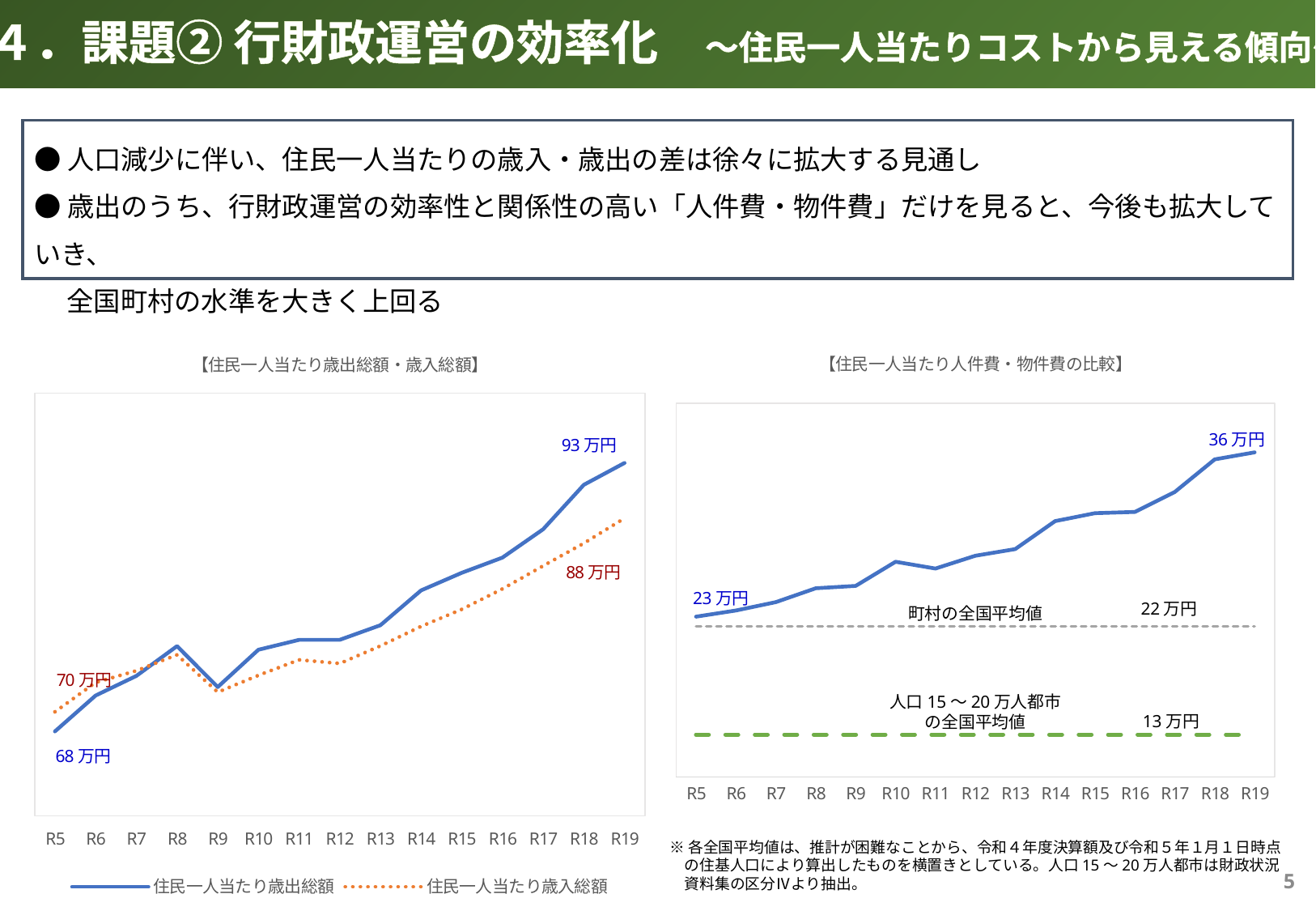
In the chart titled 【住民一人当たり人件費・物件費の比較】, what is the value of 町村の全国平均値? 22万円 In the chart titled 【住民一人当たり人件費・物件費の比較】, what is the value of 人口15～20万人都市の全国平均値? 13万円 In the chart titled 【住民一人当たり歳出総額・歳入総額】, how many series does the legend list? 2 In the chart titled 【住民一人当たり人件費・物件費の比較】, what is the value at R19? 36万円 What kind of chart is the chart titled 【住民一人当たり人件費・物件費の比較】? line chart In the chart titled 【住民一人当たり歳出総額・歳入総額】, how many years are shown on the x axis? 15 In the chart titled 【住民一人当たり歳出総額・歳入総額】, what is the value of 住民一人当たり歳入総額 at R5? 70万円 In the chart titled 【住民一人当たり人件費・物件費の比較】, does the plotted line rise or fall from R5 to R19? rise In the chart titled 【住民一人当たり歳出総額・歳入総額】, which series is larger at R19, 住民一人当たり歳出総額 or 住民一人当たり歳入総額? 住民一人当たり歳出総額 In the chart titled 【住民一人当たり歳出総額・歳入総額】, what is the difference between 住民一人当たり歳出総額 and 住民一人当たり歳入総額 at R19? 5万円 In the chart titled 【住民一人当たり歳出総額・歳入総額】, what is the value of 住民一人当たり歳出総額 at R5? 68万円 In the chart titled 【住民一人当たり歳出総額・歳入総額】, what is the value of 住民一人当たり歳出総額 at R19? 93万円